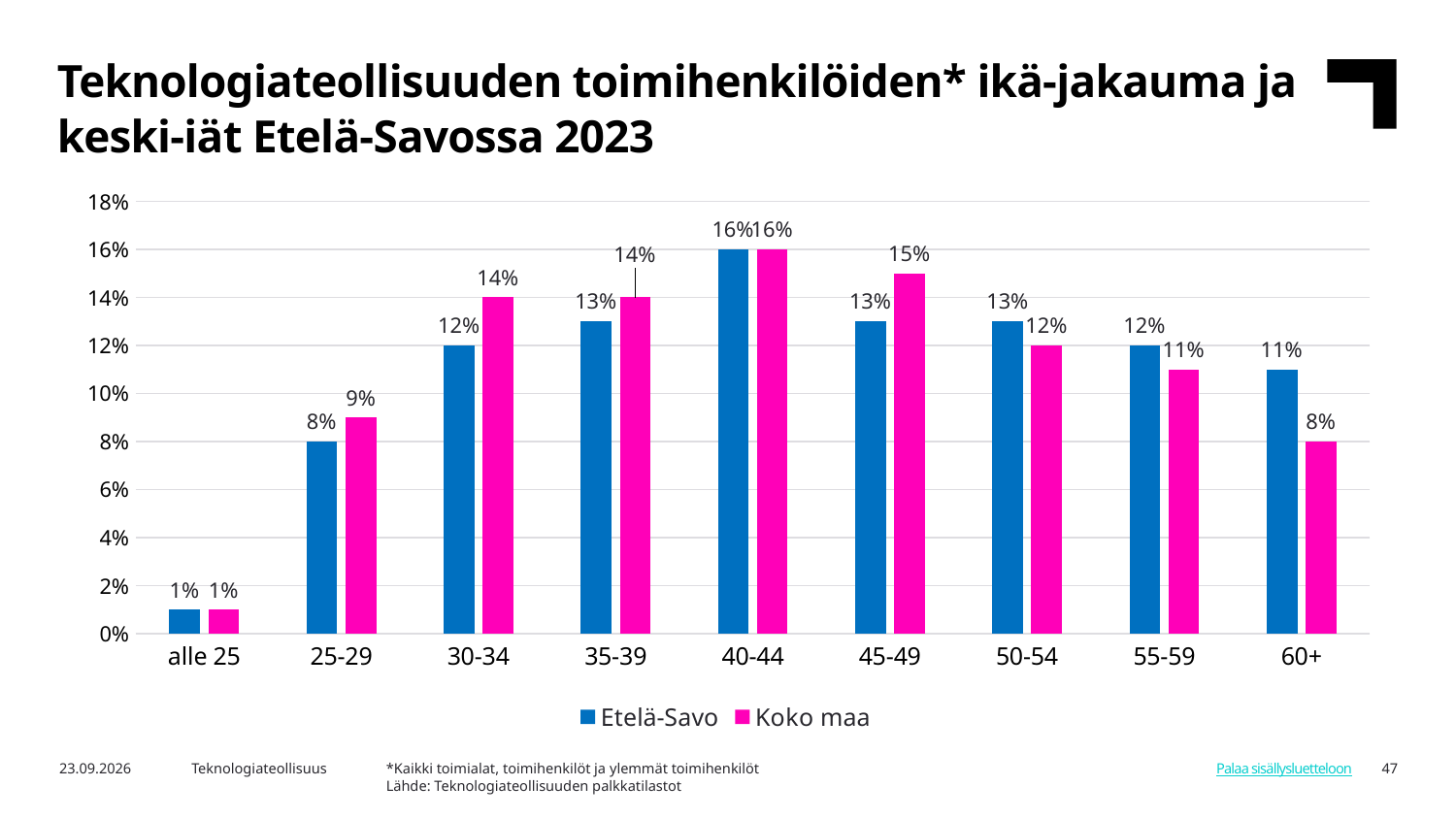
Which age group has the highest value for Koko maa? 40-44 Which age group has the lowest value for Etelä-Savo? alle 25 How many series does the legend list? 2 Is the value for Koko maa in the 25-29 age group greater or less than 10%? less In the 30-34 age group, which series has the larger value, Etelä-Savo or Koko maa? Koko maa What is the value for Etelä-Savo in the 40-44 age group? 16% How many age categories are shown on the x axis? 9 What is the value for Etelä-Savo in the 60+ age group? 11% What kind of chart is shown on the slide? bar chart What is the difference between Etelä-Savo and Koko maa in the 60+ age group? 3% Which colour represents the Koko maa series? magenta (pink) What is the value for Koko maa in the 45-49 age group? 15%